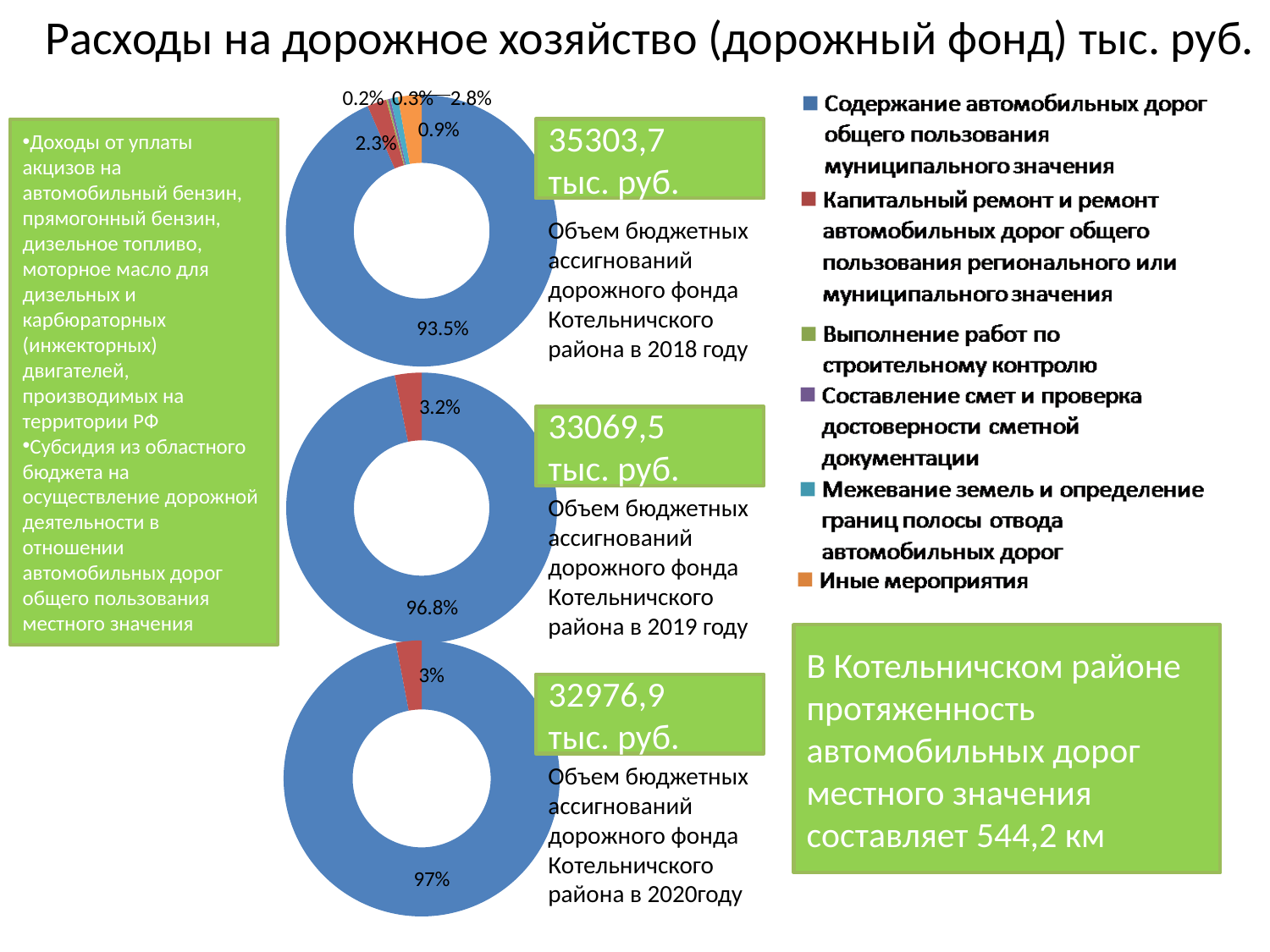
What total budget allocation is shown in the green box next to the 2018 chart? 35303,7 тыс. руб. In the 2019 chart (middle), what share does the blue slice (Содержание автомобильных дорог) have? 96.8% In the 2019 chart (middle), what share does the red slice (Капитальный ремонт и ремонт автомобильных дорог) have? 3.2% What colour represents Иные мероприятия in the legend? orange How many slices are labelled with percentages in the 2018 chart (top)? 6 How many entries does the legend on the right list? 6 What kind of chart is used for the 2018 budget allocation (top chart)? doughnut chart Which year has the larger share for Содержание автомобильных дорог: 2019 (96.8%) or 2020 (97%)? 2020 In the 2018 chart (top), what share does the red slice (Капитальный ремонт и ремонт автомобильных дорог) have? 2.3% In the 2020 chart (bottom), what is the difference in percentage points between the blue slice (97%) and the red slice (3%)? 94 percentage points